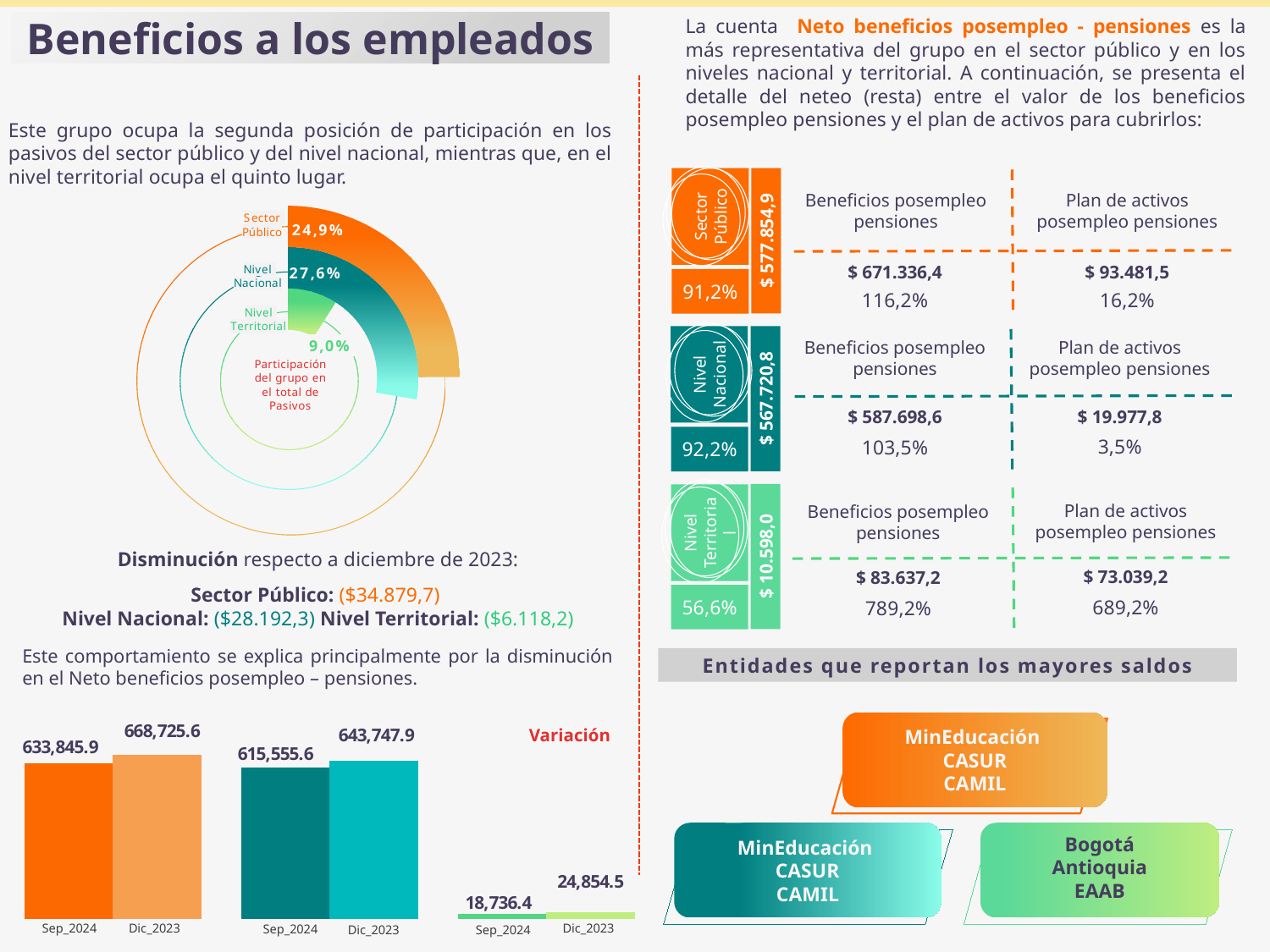
In the radial chart 'Participación del grupo en el total de Pasivos', what is the value for Sector Público? 24,9% In the bar chart at the bottom left of the slide, what is the Sep_2024 value for the first (orange) group? 633,845.9 In the radial chart 'Participación del grupo en el total de Pasivos', which category has the lowest value? Nivel Territorial In the radial chart 'Participación del grupo en el total de Pasivos', which category has the highest value? Nivel Nacional In the bar chart at the bottom left of the slide, which is larger in the second (teal) group: Sep_2024 or Dic_2023? Dic_2023 In the radial chart 'Participación del grupo en el total de Pasivos', what is the value for Nivel Nacional? 27,6% In the bar chart at the bottom left of the slide, what is the difference between the Dic_2023 and Sep_2024 values in the first (orange) group? 34,879.7 In the radial chart 'Participación del grupo en el total de Pasivos', how many categories are shown? 3 In the bar chart at the bottom left of the slide, how many bars are plotted in total? 6 In the bar chart at the bottom left of the slide, what is the Dic_2023 value for the second (teal) group? 643,747.9 In the bar chart at the bottom left of the slide, what is the Dic_2023 value for the third (green) group? 24,854.5 What kind of chart is shown at the bottom left of the slide? Bar chart